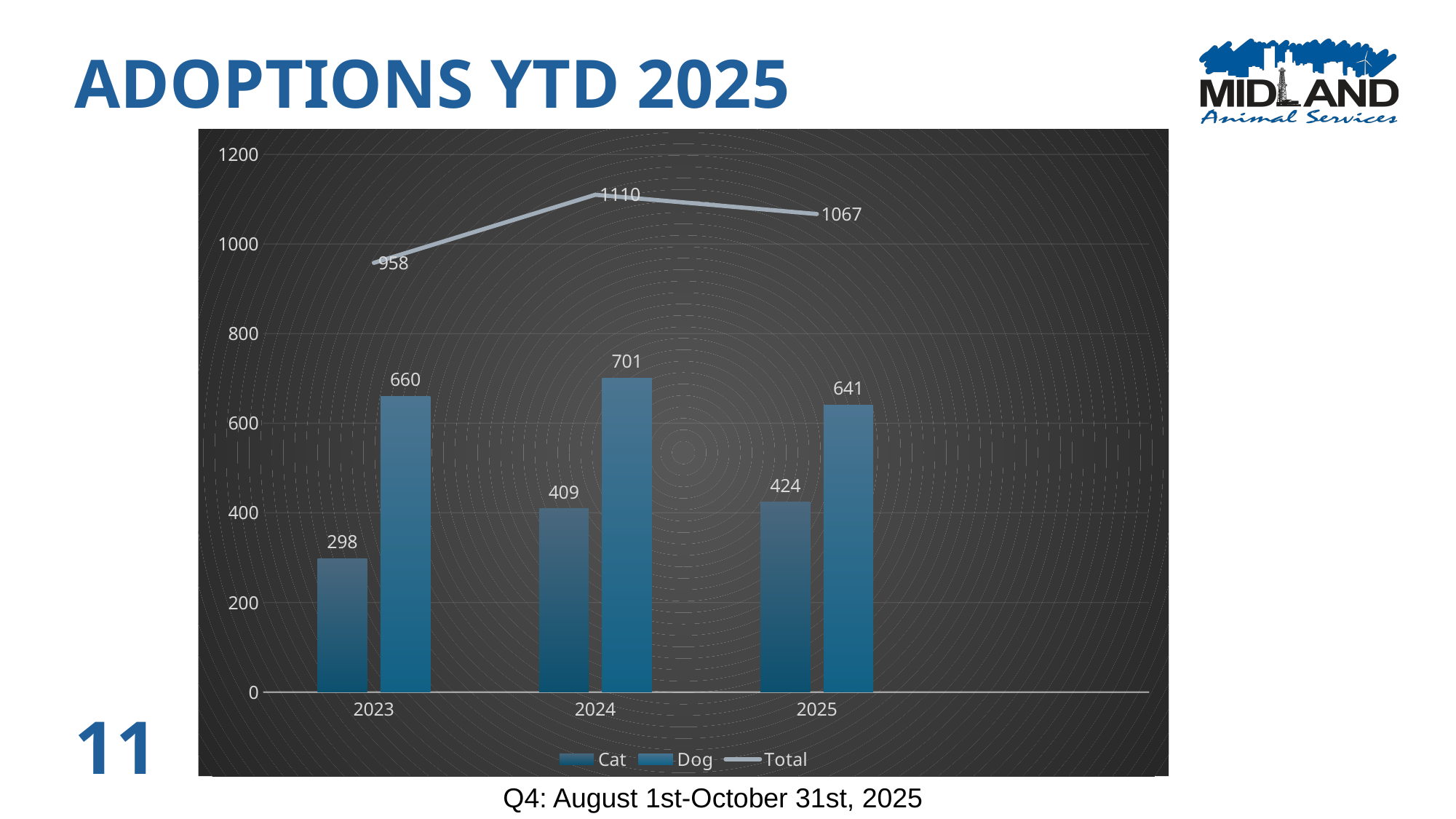
How many years are shown on the x axis? 3 What is the difference between the Dog and Cat values in 2025? 217 Which is larger, the Cat value in 2024 or the Cat value in 2025? Cat value in 2025 What is the Total value for 2025? 1067 How many series does the legend list? 3 What is the value for Cat in 2023? 298 Which year has the lowest Cat value? 2023 Does the Dog value rise or fall from 2024 to 2025? fall Is the Dog value for 2023 greater or less than 600? greater What kind of chart is used for the Cat and Dog series? bar chart Which year has the highest Total value? 2024 What is the value for Dog in 2024? 701